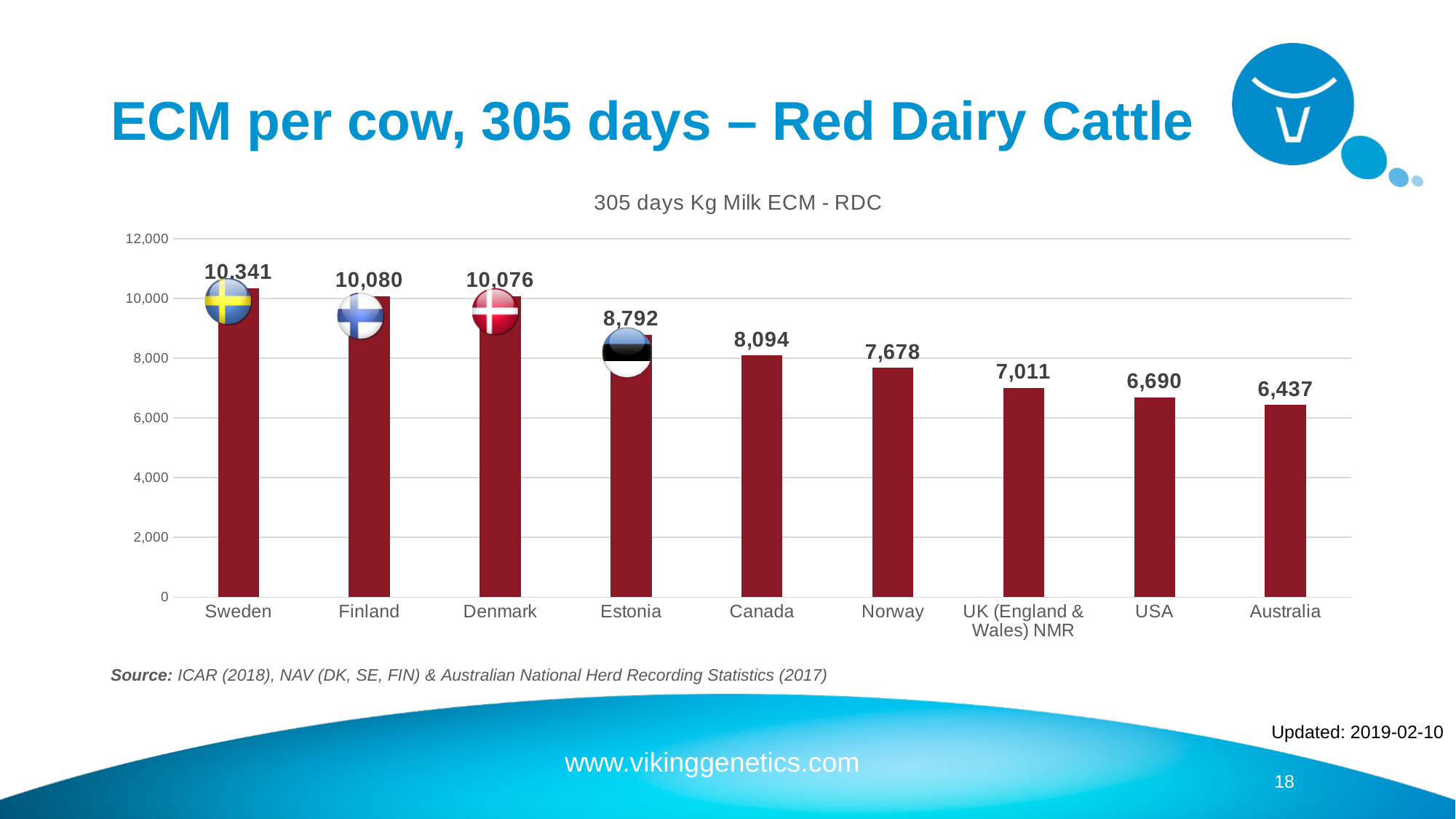
What is the value shown for UK (England & Wales) NMR? 7,011 What is the title of the chart? 305 days Kg Milk ECM - RDC How many countries are shown on the chart? 9 Which has a larger value, Estonia or Canada? Estonia What is the difference between the values for Sweden and Australia? 3,904 What is the difference between the values for Canada and Norway? 416 Which country has the lowest value on the chart? Australia What kind of chart is shown on the slide? bar chart What is the 305 days Kg Milk ECM value for Sweden? 10,341 What is the value shown for Estonia? 8,792 Is the value for USA greater or less than 8,000? less Which country has the highest 305 days Kg Milk ECM value? Sweden